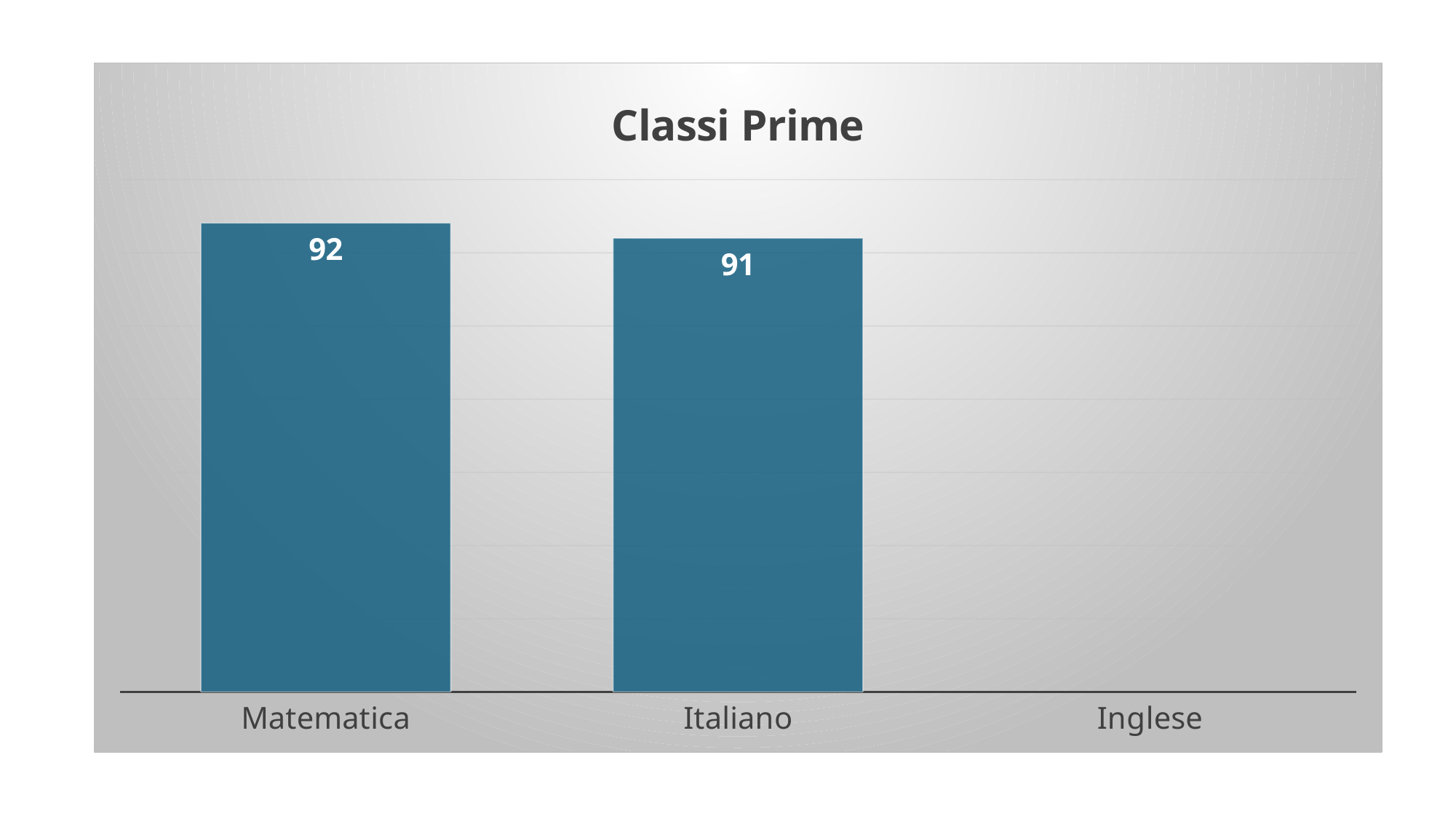
What is the value for Italiano? 91 What kind of chart is this? bar chart Which category has the highest value? Matematica What is the difference between the values for Matematica and Italiano? 1 What is the value for Matematica? 92 Do the values fall or rise from Matematica to Italiano? fall Which category on the x axis has no bar plotted? Inglese How many categories are shown on the x axis? 3 What is the title of the chart? Classi Prime Which is larger, the value for Matematica or the value for Italiano? Matematica